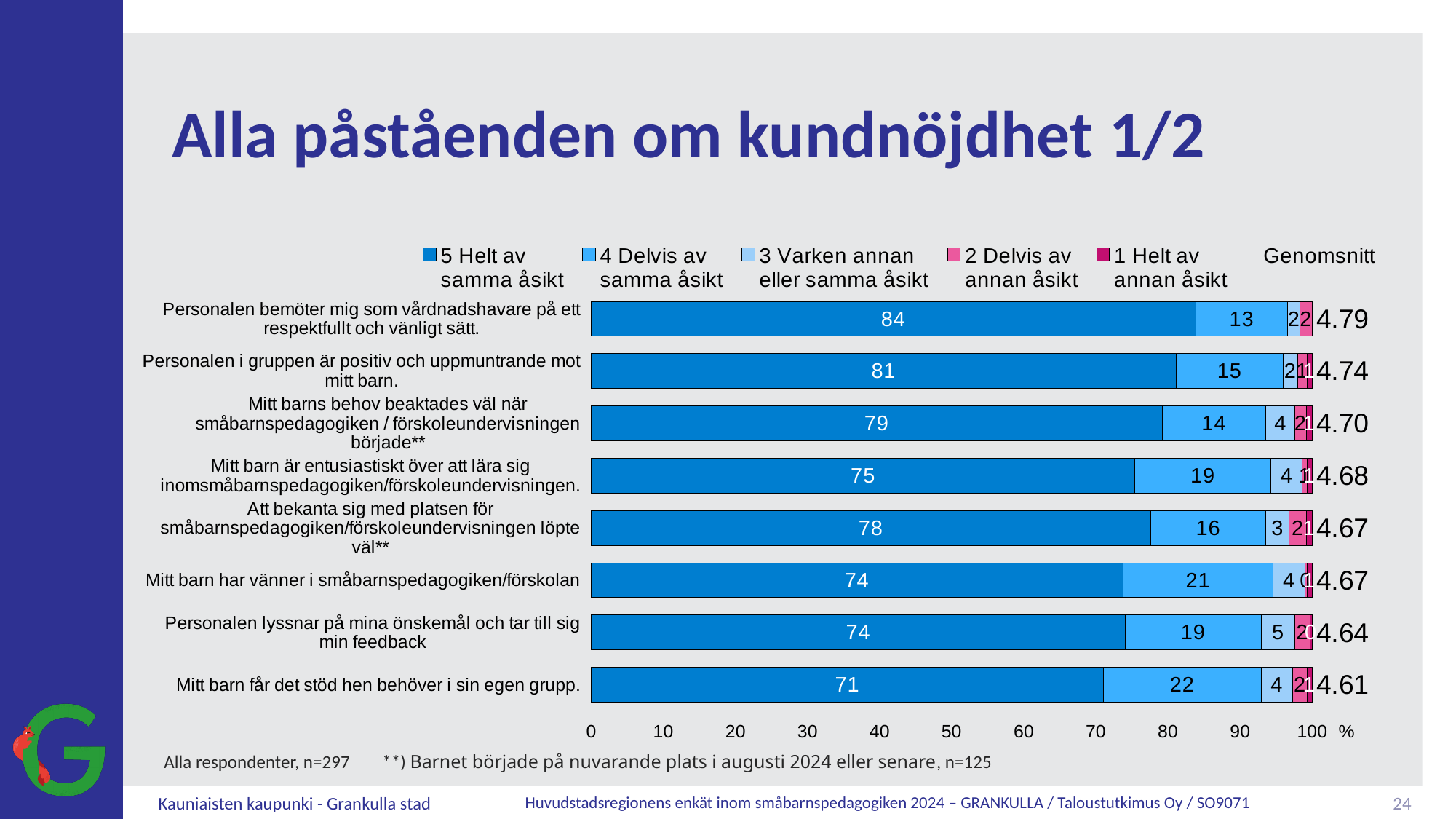
What percentage of respondents answered "4 Delvis av samma åsikt" for "Mitt barn har vänner i småbarnspedagogiken/förskolan"? 21 How many respondents are included in the chart (Alla respondenter)? n=297 What percentage of respondents answered "5 Helt av samma åsikt" for "Personalen bemöter mig som vårdnadshavare på ett respektfullt och vänligt sätt."? 84 What is the Genomsnitt value for "Personalen i gruppen är positiv och uppmuntrande mot mitt barn."? 4.74 What is the difference in the "5 Helt av samma åsikt" percentage between "Personalen bemöter mig som vårdnadshavare på ett respektfullt och vänligt sätt." (84) and "Mitt barn får det stöd hen behöver i sin egen grupp." (71)? 13 Which statement has the lowest Genomsnitt value? Mitt barn får det stöd hen behöver i sin egen grupp. What type of chart is shown on the slide? Stacked bar chart What is the Genomsnitt (average) shown for "Mitt barn får det stöd hen behöver i sin egen grupp."? 4.61 Which statement has the highest share of "5 Helt av samma åsikt" responses? Personalen bemöter mig som vårdnadshavare på ett respektfullt och vänligt sätt. How many statements (bars) are shown in the chart? 8 Which has a larger "4 Delvis av samma åsikt" share: "Mitt barn får det stöd hen behöver i sin egen grupp." or "Personalen i gruppen är positiv och uppmuntrande mot mitt barn."? Mitt barn får det stöd hen behöver i sin egen grupp. How many response categories does the legend list? 5